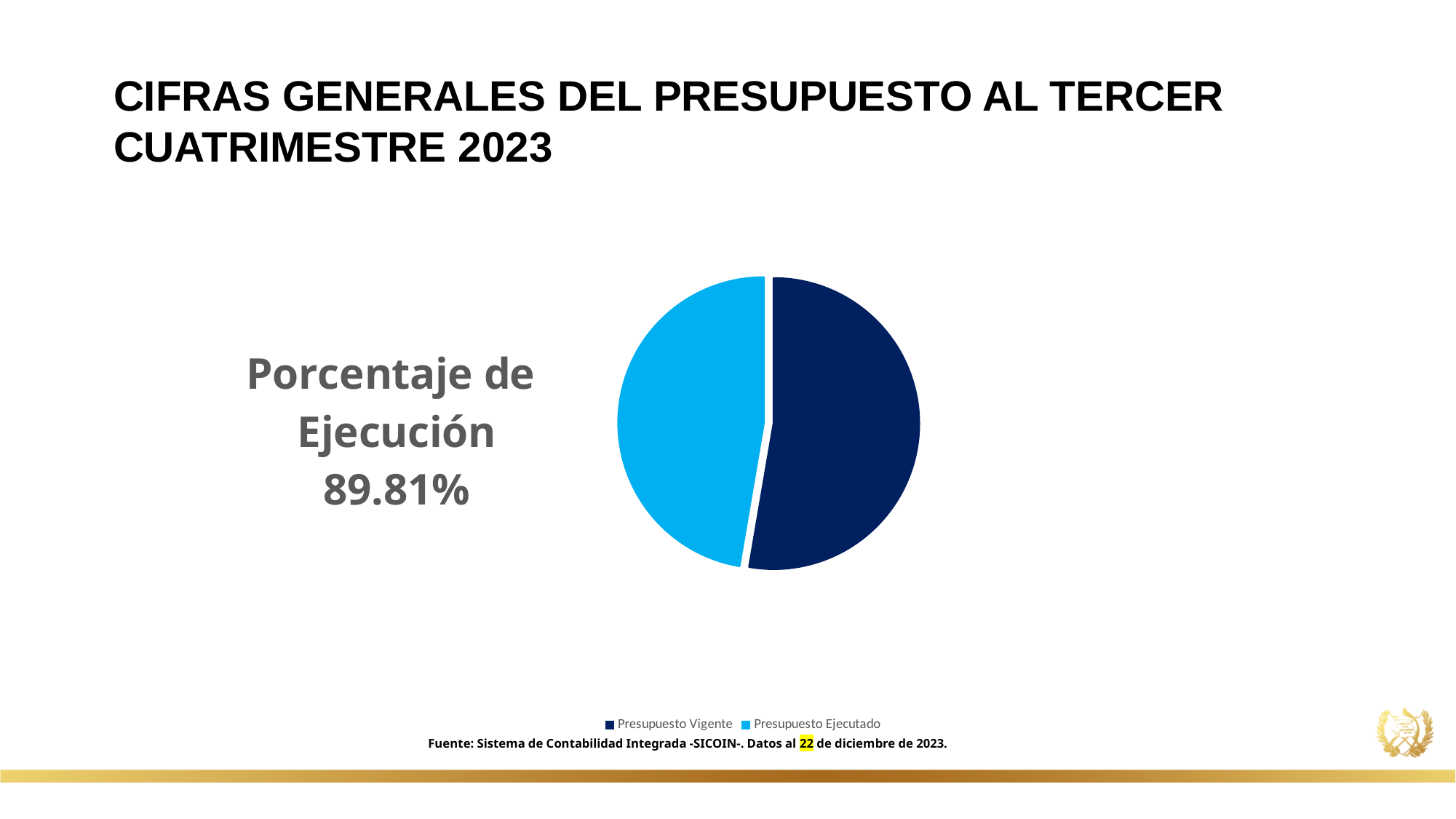
Which legend entry is shown in light blue in the pie chart? Presupuesto Ejecutado How many entries does the legend of the pie chart list? 2 What percentage of execution (Porcentaje de Ejecución) is stated next to the pie chart? 89.81% What are the two categories listed in the legend of the pie chart? Presupuesto Vigente and Presupuesto Ejecutado How many slices does the pie chart have? 2 What kind of chart is shown on the slide? Pie chart